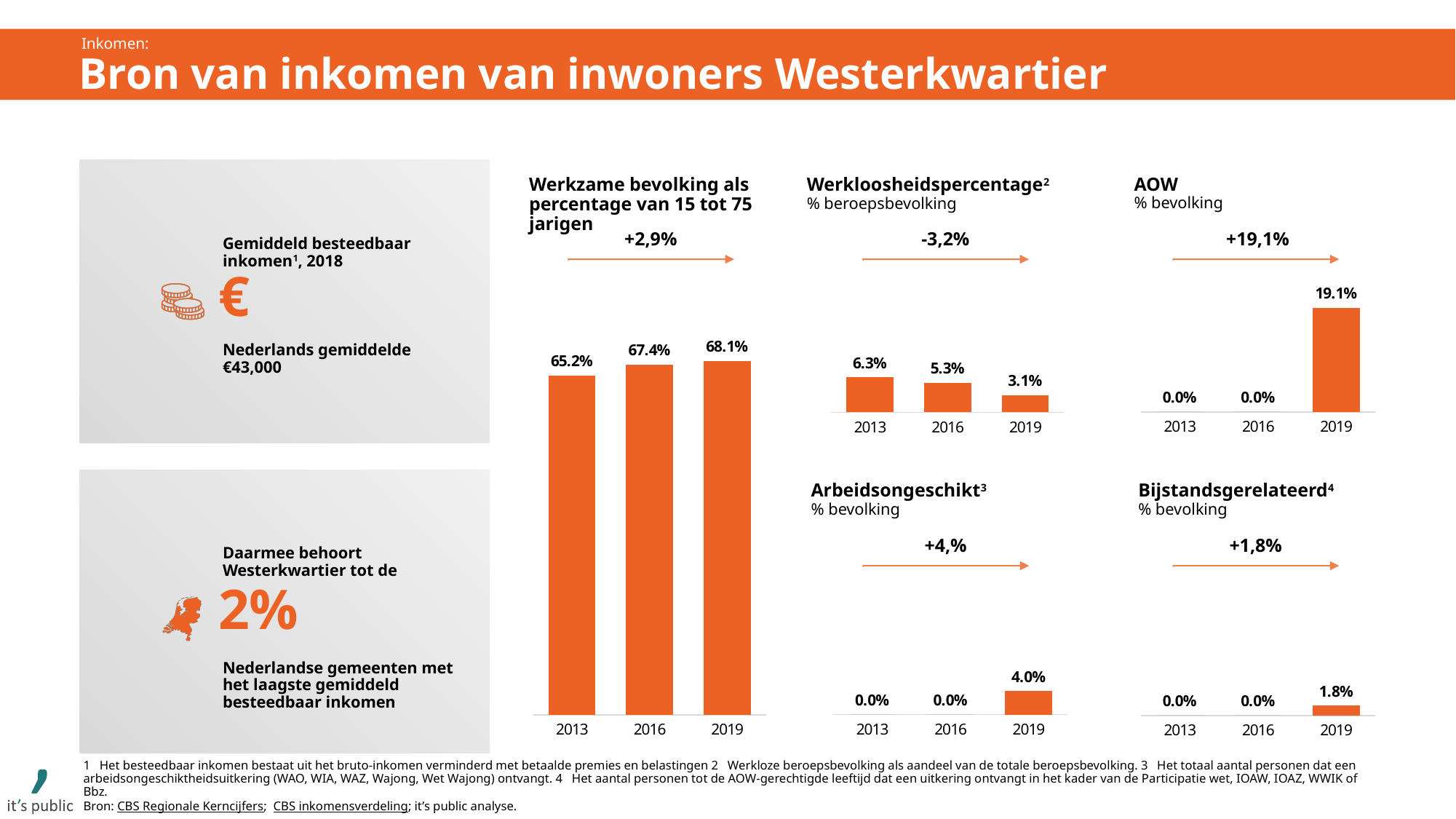
In the 'Werkloosheidspercentage' chart, do the values rise or fall from 2013 to 2019? fall In the 'Werkloosheidspercentage' chart, what is the difference between the 2013 and 2019 values? 3.2% In the 'Werkzame bevolking als percentage van 15 tot 75 jarigen' chart, what is the value for 2019? 68.1% In the 'Bijstandsgerelateerd' chart, how many years are shown on the x axis? 3 In the 'AOW' chart, what is the value for 2019? 19.1% In the 'Werkloosheidspercentage' chart, which year has the lowest value? 2019 What kind of chart is the 'Bijstandsgerelateerd' chart? bar chart In the 'Werkzame bevolking als percentage van 15 tot 75 jarigen' chart, what is the value for 2013? 65.2% In the 'Arbeidsongeschikt' chart, what is the value for 2019? 4.0% In the 'Werkloosheidspercentage' chart, what is the value for 2016? 5.3% In the 'Werkzame bevolking als percentage van 15 tot 75 jarigen' chart, do the values rise or fall from 2013 to 2019? rise In the 'AOW' chart, what is the value for 2013? 0.0%